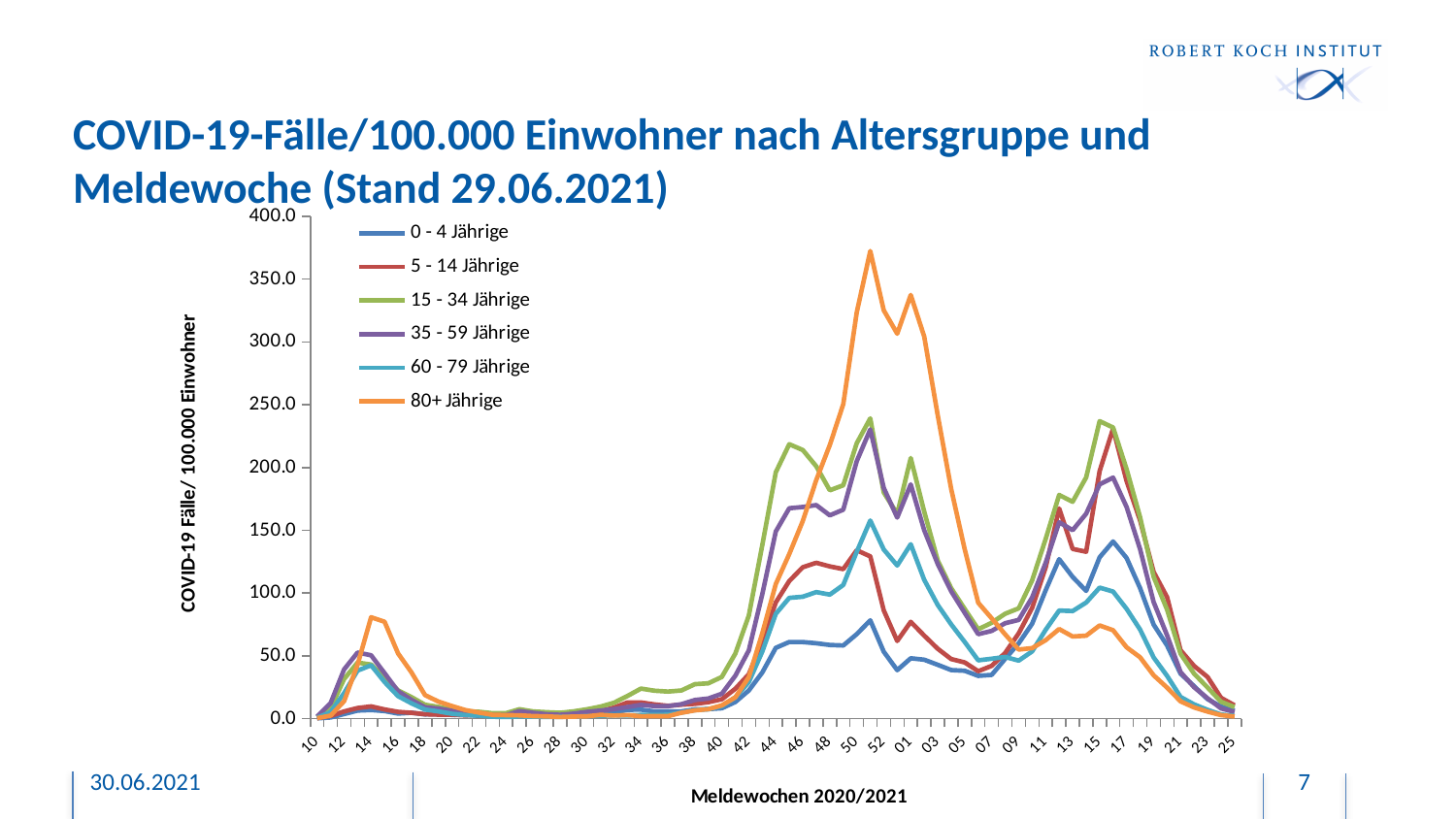
At week 51, which is larger: the value for 80+ Jährige or the value for 0 - 4 Jährige? 80+ Jährige What kind of chart is shown on the slide? line chart Is the value for 80+ Jährige around week 14 (2020) greater or less than 50? greater What is the title of the vertical axis? COVID-19 Fälle/ 100.000 Einwohner Is the value for 0 - 4 Jährige at its peak around week 17 (2021) greater or less than 100? greater How many age groups (series) does the legend list? 6 At week 51, which age group has the lowest value? 0 - 4 Jährige Which age group reaches the highest value anywhere on the chart? 80+ Jährige Is the value for 15 - 34 Jährige around week 45 greater or less than 150? greater Do the values for all age groups rise or fall between week 17 and week 25 of 2021? fall What is the title of the horizontal axis? Meldewochen 2020/2021